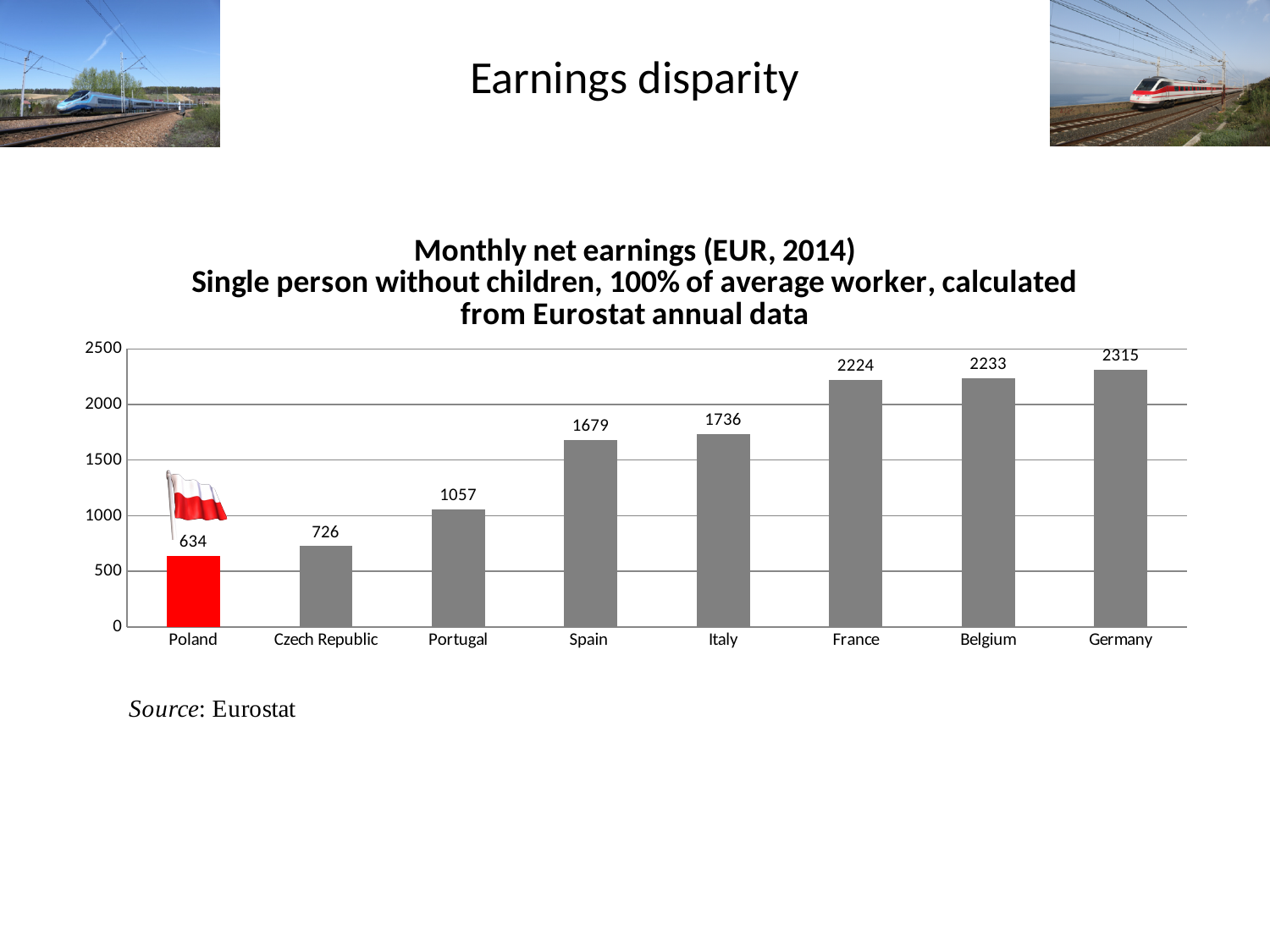
What is the difference between Germany's and Poland's monthly net earnings? 1681 What is the difference between Italy's and Spain's monthly net earnings? 57 What kind of chart is shown on the slide? Bar chart Which has higher monthly net earnings, Portugal or Czech Republic? Portugal What is the monthly net earnings value for Spain? 1679 How many countries are shown in the chart? 8 Do the values rise or fall from left to right across the countries? Rise Which country has the lowest monthly net earnings? Poland What is the monthly net earnings value for Belgium? 2233 What is the monthly net earnings value for Poland? 634 Is the value for France greater or less than 2000? greater Which country has the highest monthly net earnings? Germany